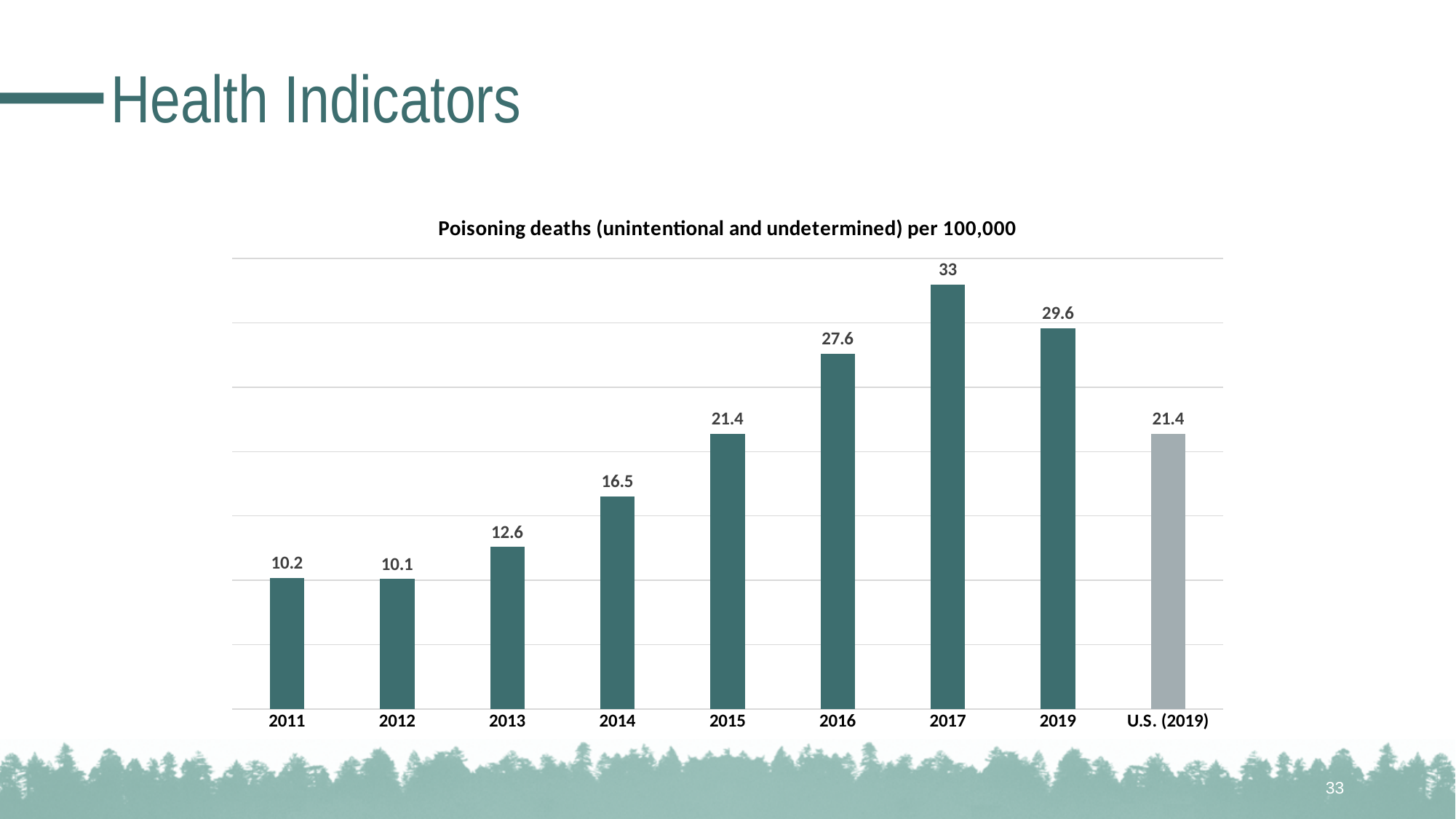
What is the difference between the values for 2019 and U.S. (2019)? 8.2 What is the title of the chart? Poisoning deaths (unintentional and undetermined) per 100,000 Which category has the highest value? 2017 Which category has the lowest value? 2012 Do the values rise or fall from 2012 to 2017? Rise What kind of chart is shown on the slide? Bar chart Which bar is shown in a different colour (grey) from the others? U.S. (2019) Which is larger, the value for 2016 or the value for 2019? 2019 What is the value for 2017? 33 How many bars are shown in the chart? 9 What is the value for 2014? 16.5 What is the value for U.S. (2019)? 21.4